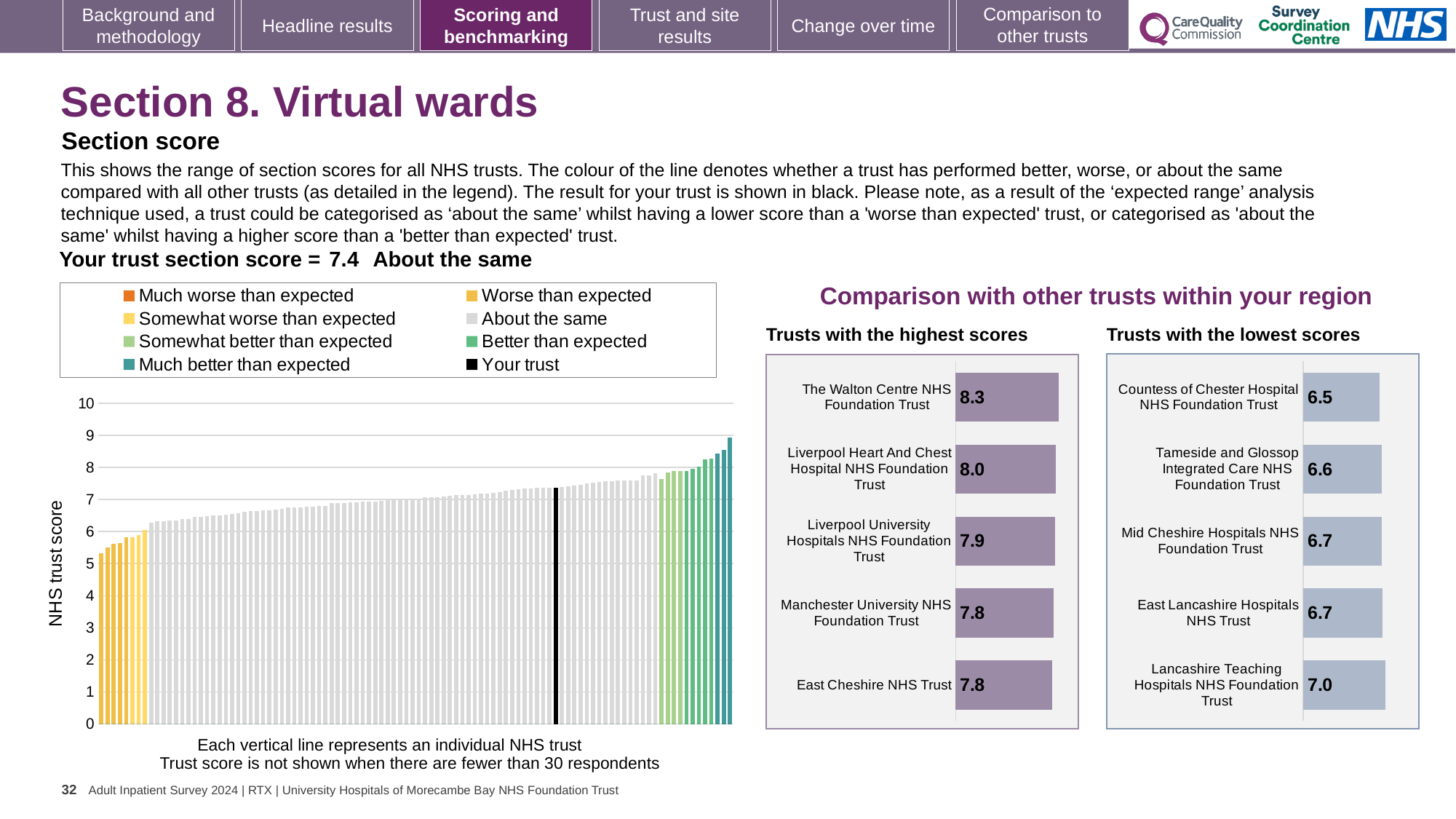
In the 'Trusts with the lowest scores' chart, which trust has the lowest score? Countess of Chester Hospital NHS Foundation Trust In the 'Trusts with the lowest scores' chart, what is the difference between the scores of Lancashire Teaching Hospitals NHS Foundation Trust and Countess of Chester Hospital NHS Foundation Trust? 0.5 In the 'Trusts with the highest scores' chart, which trust has the highest score? The Walton Centre NHS Foundation Trust How many entries does the legend of the NHS trust score chart on the left list? 8 In the 'Trusts with the highest scores' chart, what is the score for The Walton Centre NHS Foundation Trust? 8.3 In the 'Trusts with the highest scores' chart, what is the difference between the scores of The Walton Centre NHS Foundation Trust and East Cheshire NHS Trust? 0.5 In the 'Trusts with the lowest scores' chart, which has the higher score: Tameside and Glossop Integrated Care NHS Foundation Trust or Mid Cheshire Hospitals NHS Foundation Trust? Mid Cheshire Hospitals NHS Foundation Trust In the 'Trusts with the lowest scores' chart, what is the score for Lancashire Teaching Hospitals NHS Foundation Trust? 7.0 How many trusts are listed in the 'Trusts with the lowest scores' chart? 5 In the NHS trust score chart on the left, do the bar heights rise or fall from left to right? rise In the 'Trusts with the highest scores' chart, what is the score for Liverpool Heart And Chest Hospital NHS Foundation Trust? 8.0 What kind of chart is the 'Trusts with the highest scores' chart? bar chart